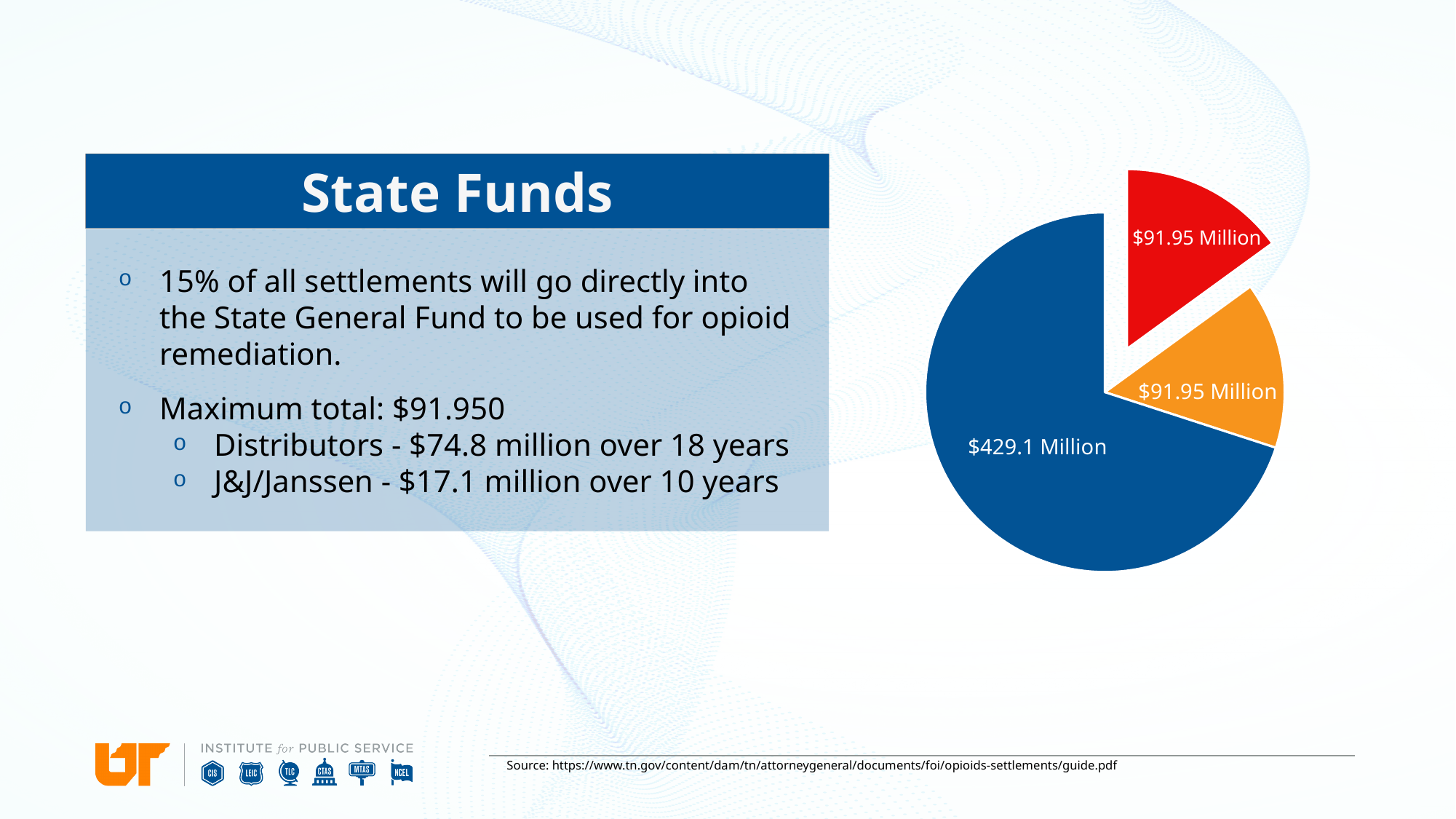
What share of the pie chart does the red slice represent? 15% What is the total of all three slices in the pie chart? $613 Million Which slice of the pie chart is pulled out (exploded) from the rest of the pie? The red slice What value is labelled on the blue slice of the pie chart? $429.1 Million What value is labelled on the orange slice of the pie chart? $91.95 Million How many slices does the pie chart have? 3 What share of the pie chart does the blue slice represent? 70% What value is labelled on the red slice of the pie chart? $91.95 Million What kind of chart is shown on the slide? Pie chart Which is larger, the blue slice or the red slice of the pie chart? The blue slice Which slice of the pie chart is the largest? The blue slice ($429.1 Million) What is the difference between the blue slice and the red slice of the pie chart? $337.15 Million